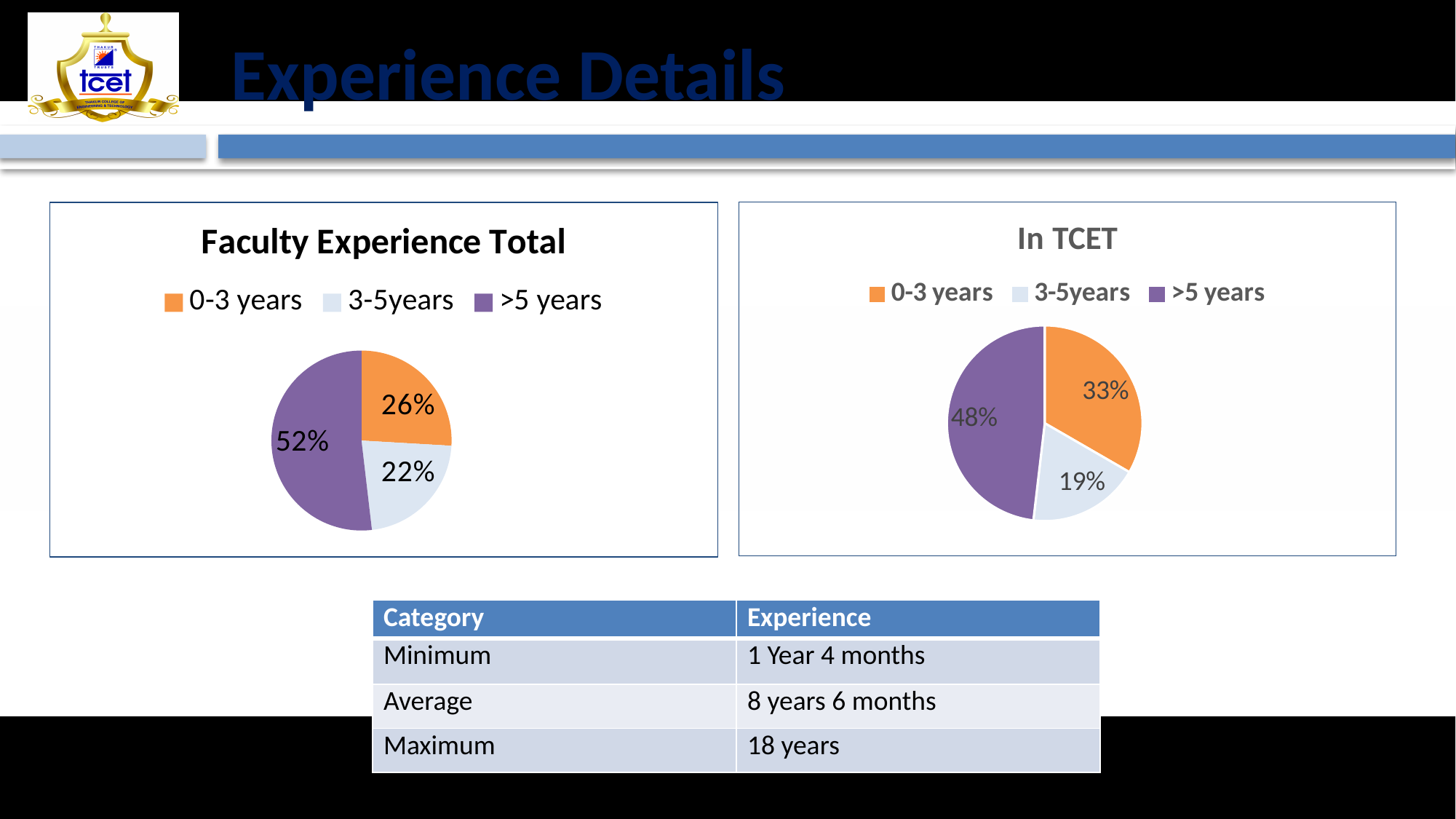
In the 'In TCET' chart, what share of the pie is the '>5 years' slice? 48% In the 'Faculty Experience Total' chart, which is larger, the '0-3 years' slice or the '3-5years' slice? 0-3 years How many series does the legend of the 'In TCET' chart list? 3 In the 'In TCET' chart, what share of the pie is the '3-5years' slice? 19% In the 'In TCET' chart, what share of the pie is the '0-3 years' slice? 33% In the 'Faculty Experience Total' chart, which category has the largest slice? >5 years In the 'In TCET' chart, which category has the smallest slice? 3-5years What kind of chart is the 'Faculty Experience Total' chart? Pie chart In the 'In TCET' chart, what is the difference in percentage points between the '>5 years' slice and the '0-3 years' slice? 15